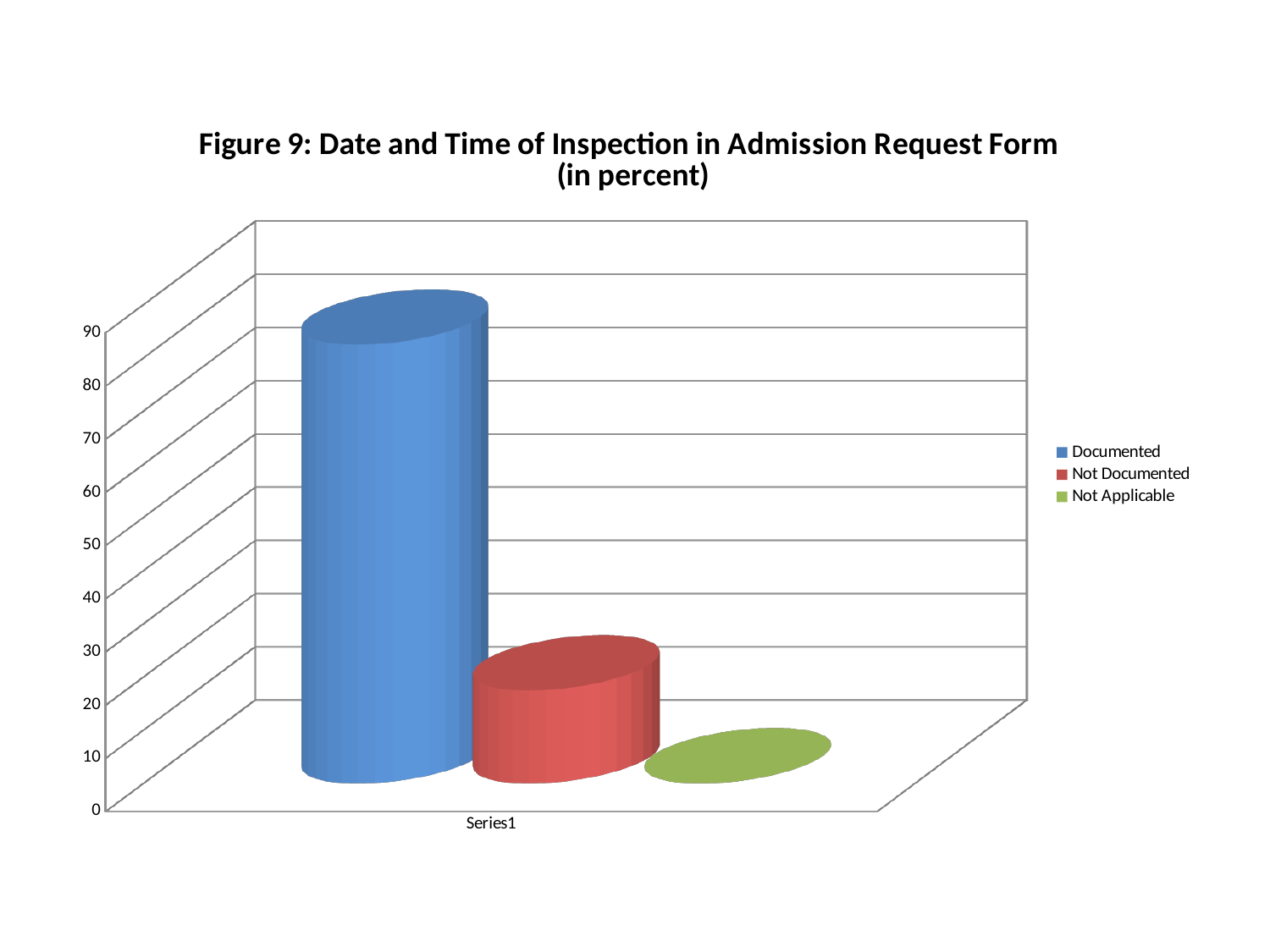
Which series has the highest value? Documented Which is larger, the value for Documented or the value for Not Documented? Documented How many series does the legend list? 3 Is the value for Documented greater or less than 50? greater What colour represents the Not Documented series? red What kind of chart is shown on the slide? bar chart Is the value for Not Applicable greater or less than 10? less Is the value for Not Documented greater or less than 50? less How many categories are shown on the x axis? 1 Which is larger, the value for Not Documented or the value for Not Applicable? Not Documented What is the title of the chart? Figure 9: Date and Time of Inspection in Admission Request Form (in percent) Which series has the lowest value? Not Applicable